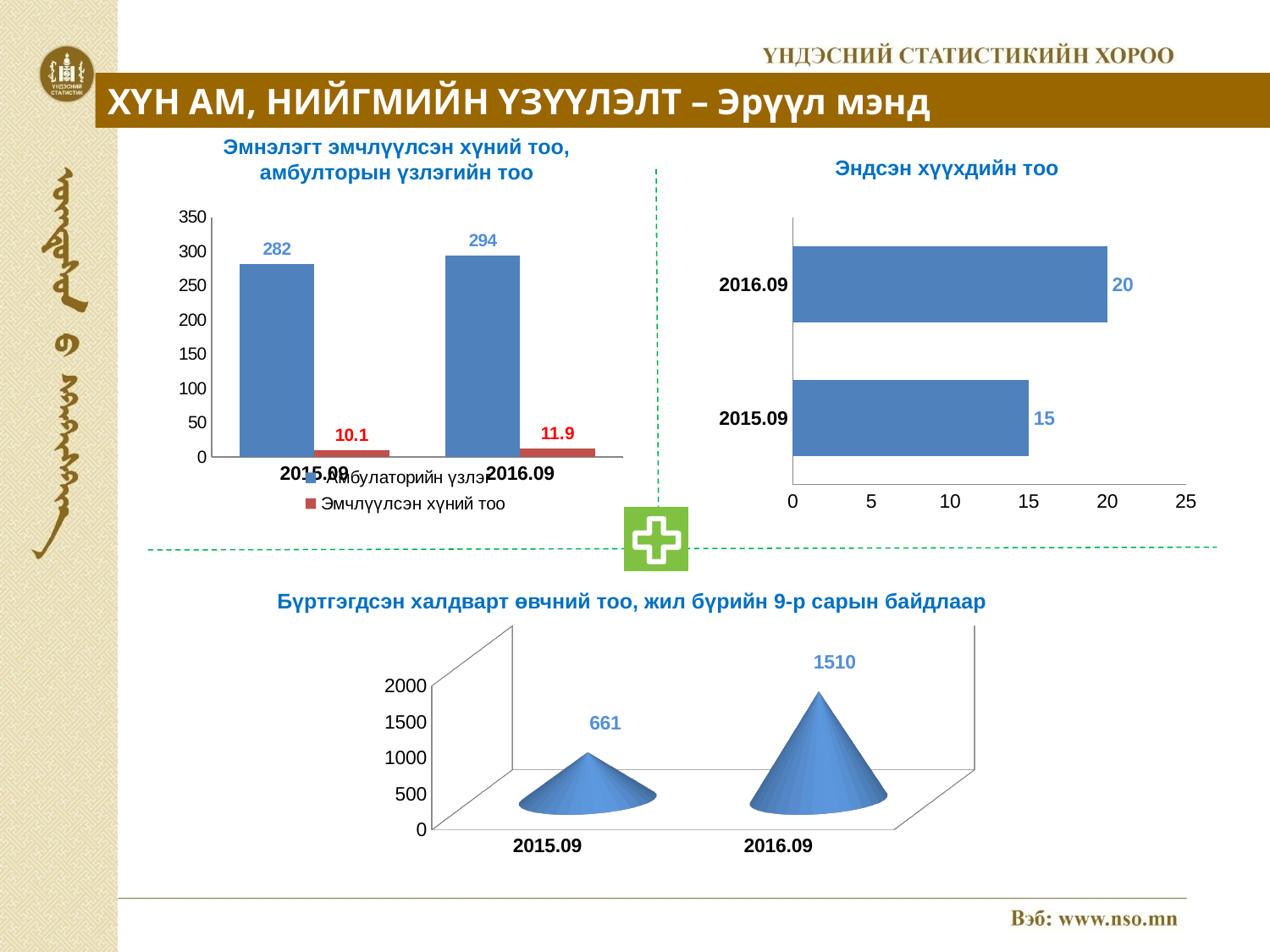
In the top-left chart, what is the difference between the Амбулаторийн үзлэг values for 2016.09 and 2015.09? 12 In the top-left chart, which year has the higher Амбулаторийн үзлэг value, 2015.09 or 2016.09? 2016.09 In the chart titled 'Эндсэн хүүхдийн тоо', what is the value for 2016.09? 20 In the top-left chart, how many series does the legend list? 2 What kind of chart is the chart titled 'Эндсэн хүүхдийн тоо'? bar chart In the top-left chart, what is the value of Эмчлүүлсэн хүний тоо for 2015.09? 10.1 In the bottom chart, what is the value for 2015.09? 661 In the chart titled 'Эндсэн хүүхдийн тоо', what is the value for 2015.09? 15 In the bottom chart, do the values rise or fall from 2015.09 to 2016.09? rise In the chart titled 'Эндсэн хүүхдийн тоо', what is the difference between the 2016.09 and 2015.09 values? 5 In the top-left chart, what is the value of Амбулаторийн үзлэг for 2016.09? 294 In the bottom chart titled 'Бүртгэгдсэн халдварт өвчний тоо, жил бүрийн 9-р сарын байдлаар', what is the value for 2016.09? 1510